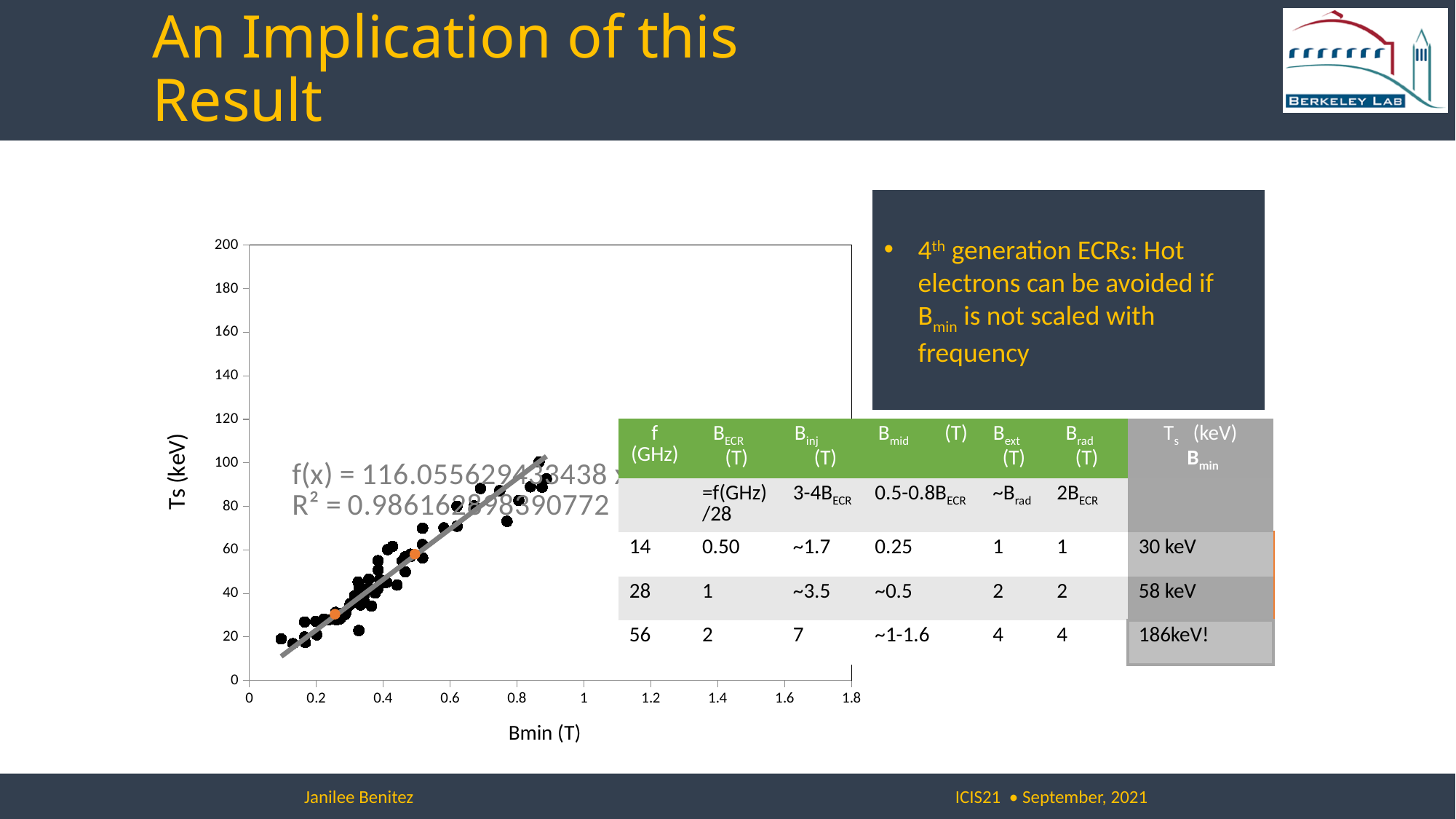
What kind of chart is shown on the slide? scatter chart What is the title of the y axis of the chart? Ts (keV) What is the title of the x axis of the chart? Bmin (T) What is the highest tick value shown on the y axis of the chart? 200 Do the plotted Ts values rise or fall as Bmin increases along the x axis? rise What is the highest tick value shown on the x axis of the chart? 1.8 Is the Ts value of the orange point near Bmin = 0.5 greater or less than 40? greater Is the Ts value of the highest plotted point (near Bmin = 0.85) greater or less than 80? greater Is the Ts value of the orange point near Bmin = 0.25 greater or less than 40? less